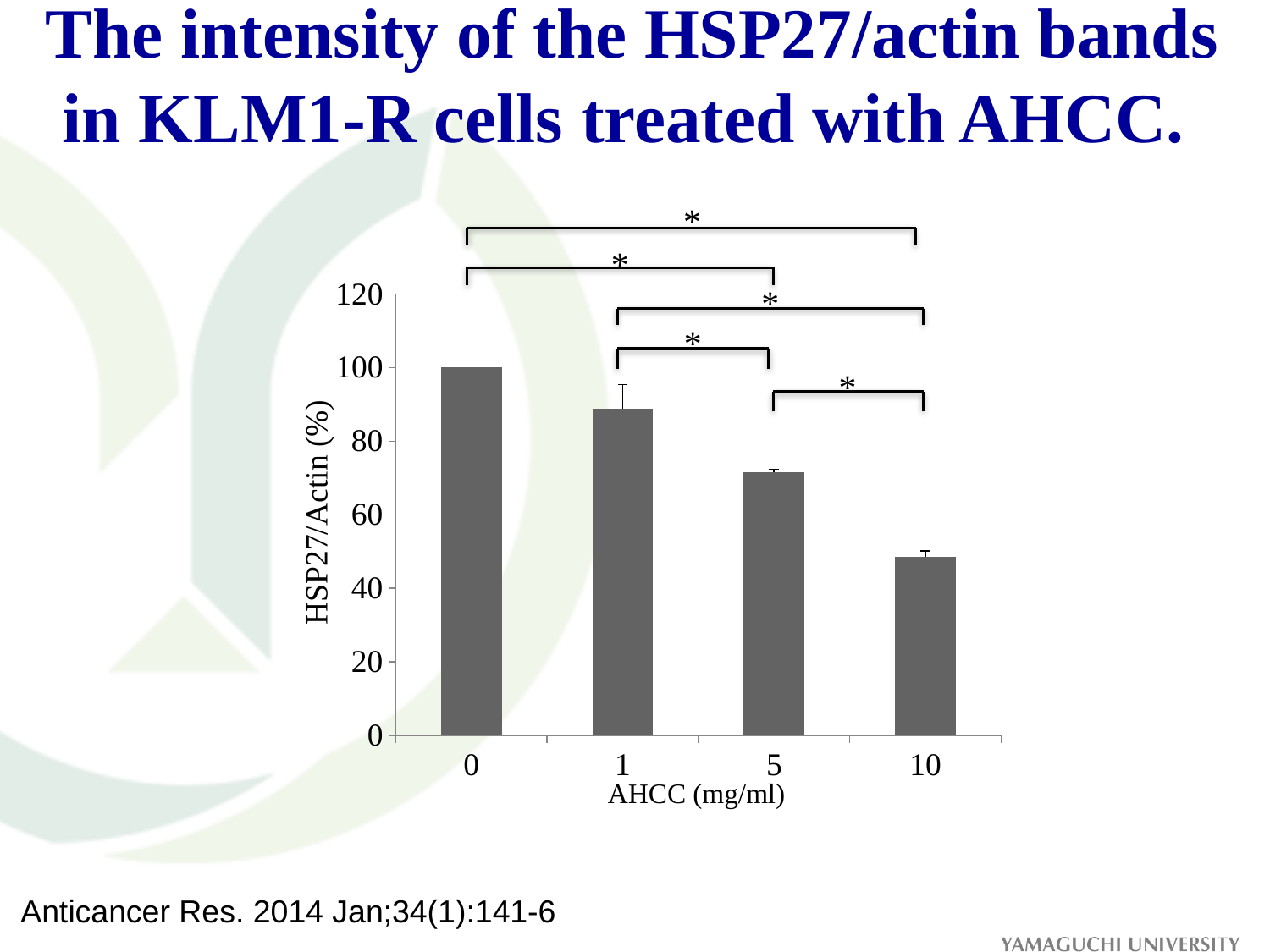
Which AHCC concentration has the highest HSP27/Actin (%) value? 0 What is the label of the x axis of the chart? AHCC (mg/ml) Is the HSP27/Actin (%) value for 10 mg/ml AHCC greater or less than 60? less Is the HSP27/Actin (%) value for 5 mg/ml AHCC greater or less than 80? less Which AHCC concentration has the lowest HSP27/Actin (%) value? 10 Do the HSP27/Actin (%) values rise or fall as the AHCC concentration increases along the x axis? fall What is the label of the y axis of the chart? HSP27/Actin (%) How many bars (AHCC concentrations) are plotted in the chart? 4 Which has a larger HSP27/Actin (%) value, 1 mg/ml or 5 mg/ml AHCC? 1 mg/ml Is the HSP27/Actin (%) value for 1 mg/ml AHCC greater or less than 80? greater What kind of chart is shown on the slide? bar chart What is the HSP27/Actin (%) value for the 0 mg/ml AHCC bar? 100